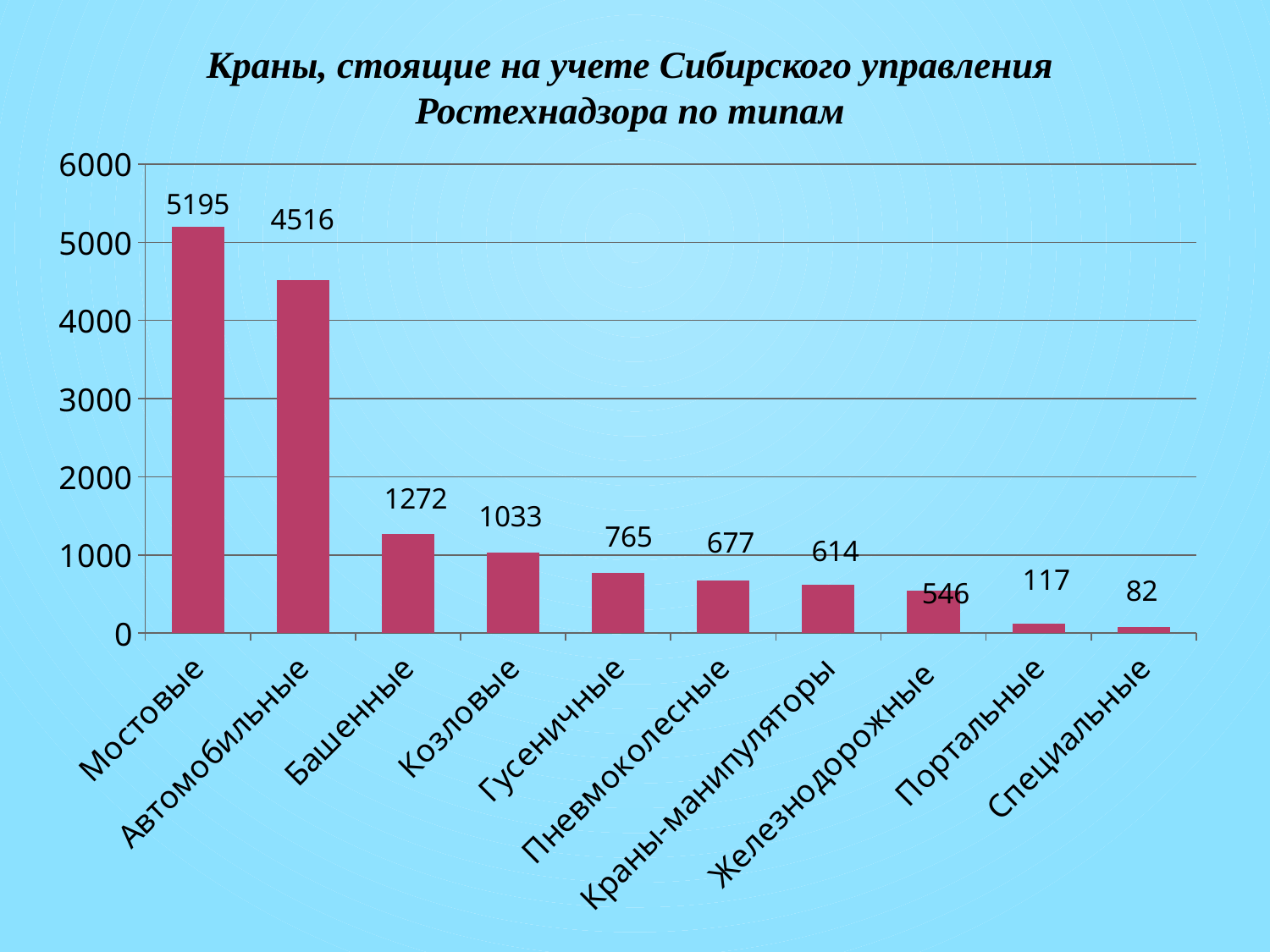
Which is larger, the value for Пневмоколесные or the value for Краны-манипуляторы? Пневмоколесные What is the difference between the values for Мостовые and Автомобильные? 679 What kind of chart is shown on the slide? bar chart What is the value for Мостовые? 5195 Which category has the highest value? Мостовые What is the value for Башенные? 1272 Do the values rise or fall from left to right along the x axis? fall What is the difference between the values for Козловые and Гусеничные? 268 Which category has the lowest value? Специальные What is the value for Железнодорожные? 546 Is the value for Автомобильные greater or less than 4000? greater How many categories are shown on the chart? 10